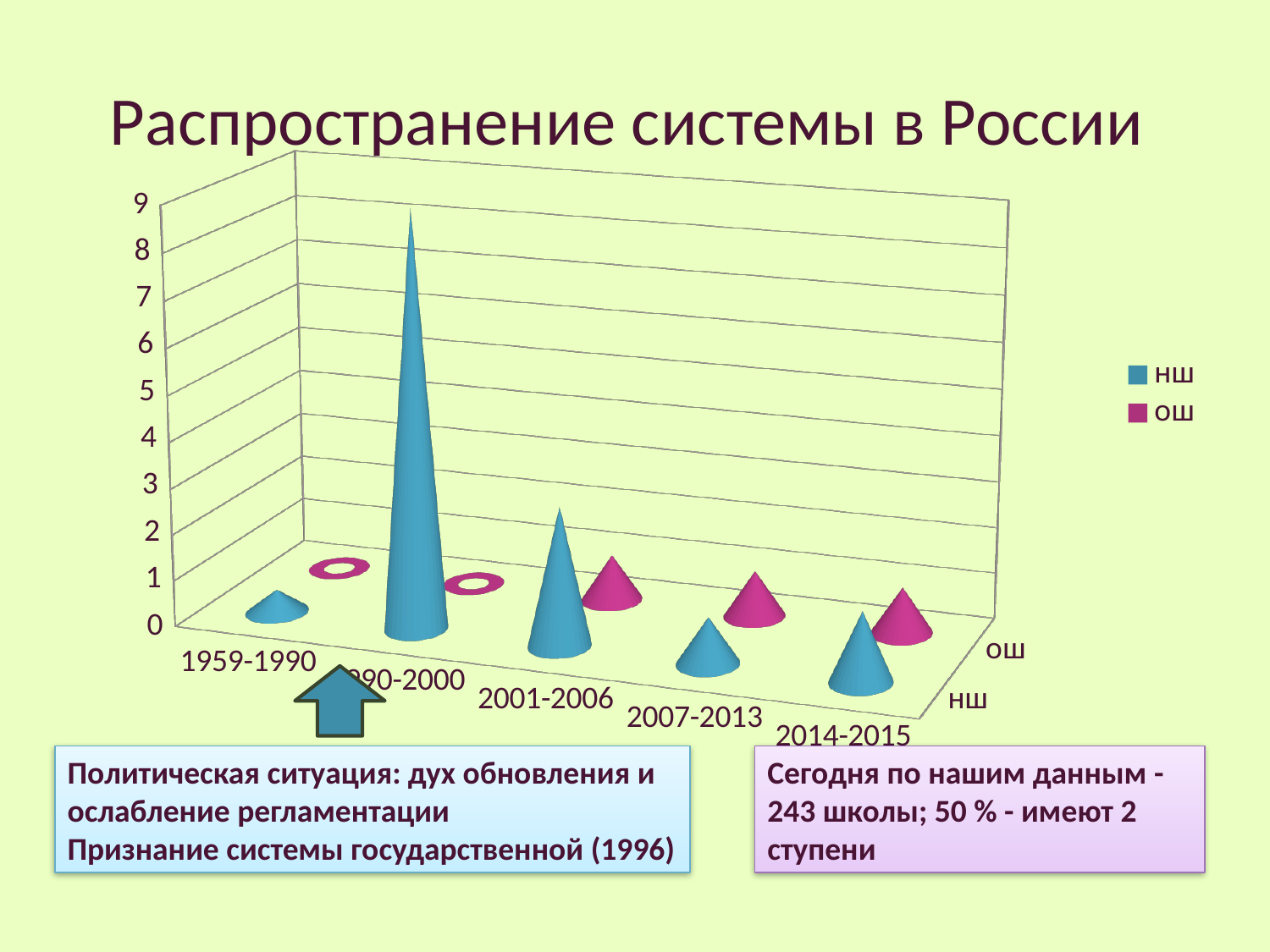
Is the value for нш in 1990-2000 greater or less than 5? greater In 2001-2006, which series has the larger value, нш or ош? нш How many period categories are shown on the x axis? 5 Which period has the highest value for the нш series? 1990-2000 What colour represents the ош series in the legend? magenta In 1990-2000, which series has the larger value, нш or ош? нш Is the value for нш in 1959-1990 greater or less than 2? less Is the value for ош in 2001-2006 greater or less than 3? less What is the title of the chart? Распространение системы в России How many series does the legend list? 2 What kind of chart is shown on the slide? bar chart Which period has the lowest value for the нш series? 1959-1990